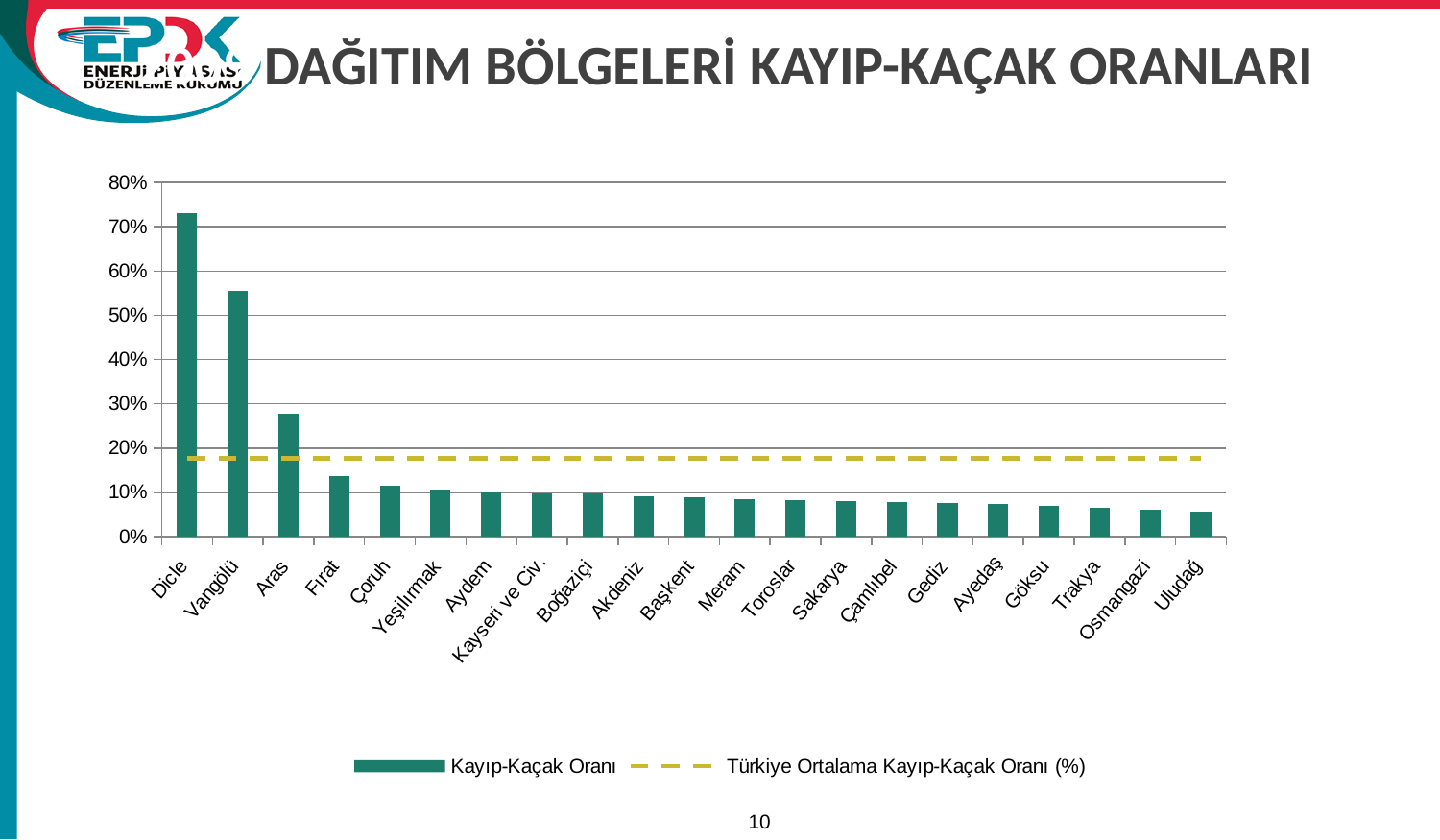
How many distribution regions are shown on the x axis? 21 Which distribution region has the highest Kayıp-Kaçak Oranı? Dicle Is the value for Aras greater or less than 30%? less How many series does the legend list? 2 Is the value for Fırat greater or less than 20%? less What kind of chart is shown on the slide? bar chart Is the value for Uludağ greater or less than 10%? less Do the bar values rise or fall from left to right along the x axis? fall Which has a larger Kayıp-Kaçak Oranı, Dicle or Vangölü? Dicle Which distribution region has the lowest Kayıp-Kaçak Oranı? Uludağ